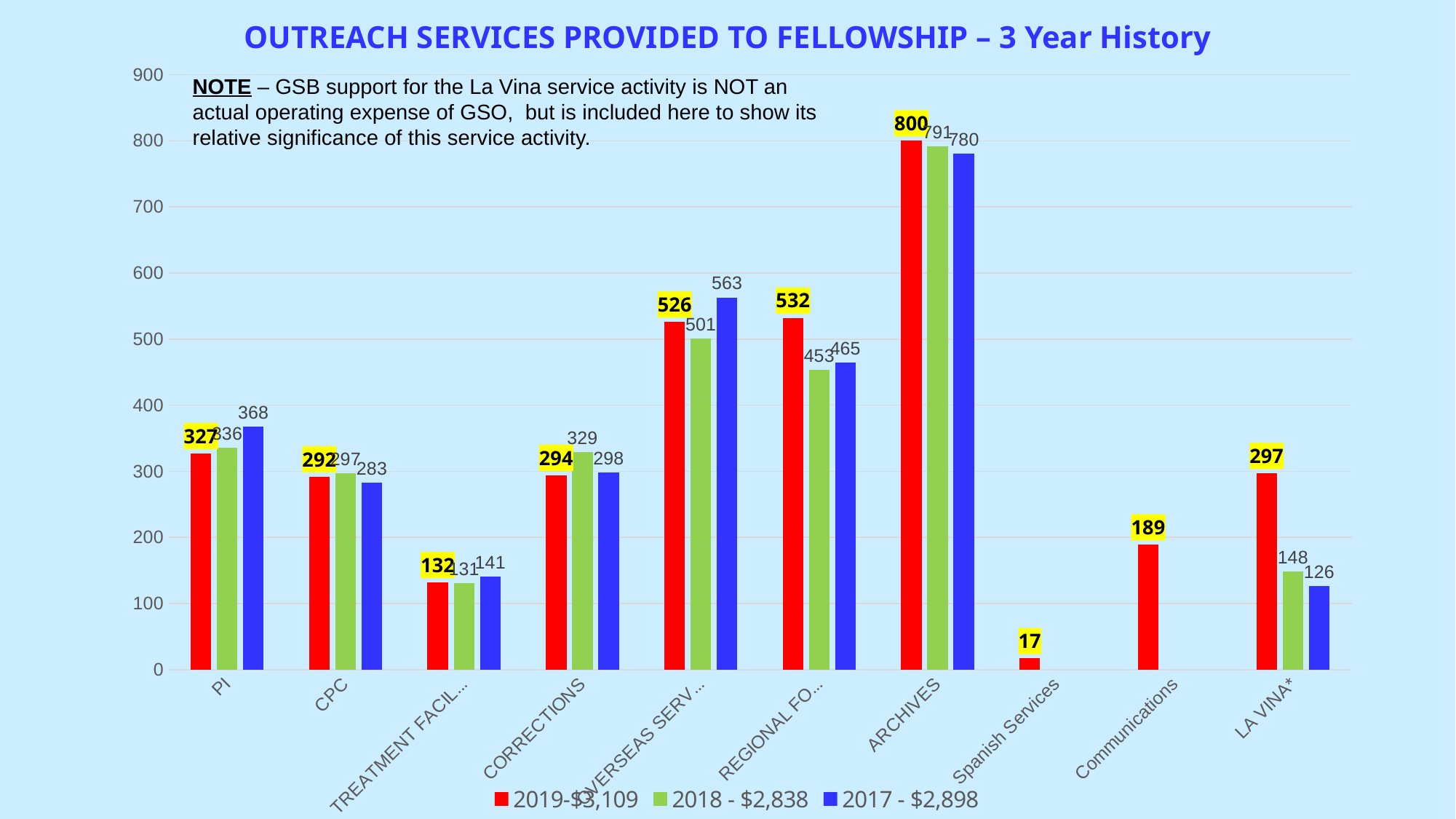
What is the 2019 value for ARCHIVES? 800 Which category has the highest 2019 value? ARCHIVES What is the 2017 value for PI? 368 How many series does the legend list? 3 For CORRECTIONS, which is larger: the 2018 value or the 2019 value? 2018 What kind of chart is shown on the slide? Bar chart What is the 2019 value for Spanish Services? 17 What is the difference between the 2019 and 2017 values for LA VINA*? 171 What is the difference between the 2019 and 2017 values for ARCHIVES? 20 What is the 2018 value for LA VINA*? 148 Which category has the lowest 2019 value? Spanish Services How many categories are shown on the x axis? 10